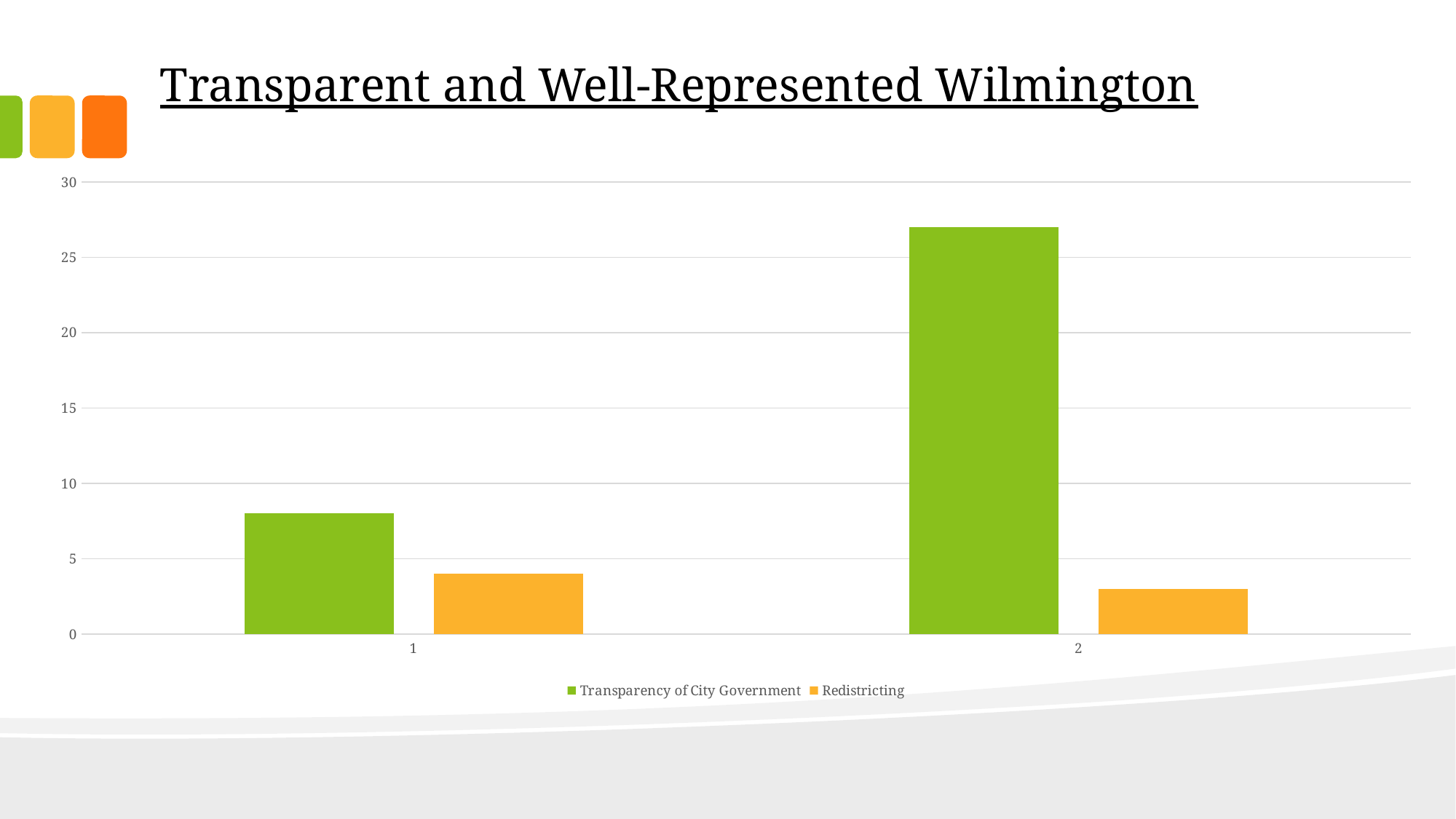
Is the value for Transparency of City Government in category 2 greater or less than 25? greater What colour represents the Redistricting series? orange Is the value for Transparency of City Government in category 1 greater or less than 10? less How many series does the legend list? 2 Is the value for Redistricting in category 1 greater or less than 5? less What kind of chart is shown on the slide? bar chart In category 2, which series has the larger value, Transparency of City Government or Redistricting? Transparency of City Government Which category has the highest value for Transparency of City Government? 2 How many categories are shown on the x axis? 2 Does the value for Transparency of City Government rise or fall from category 1 to category 2? rise In category 1, which series has the larger value, Transparency of City Government or Redistricting? Transparency of City Government